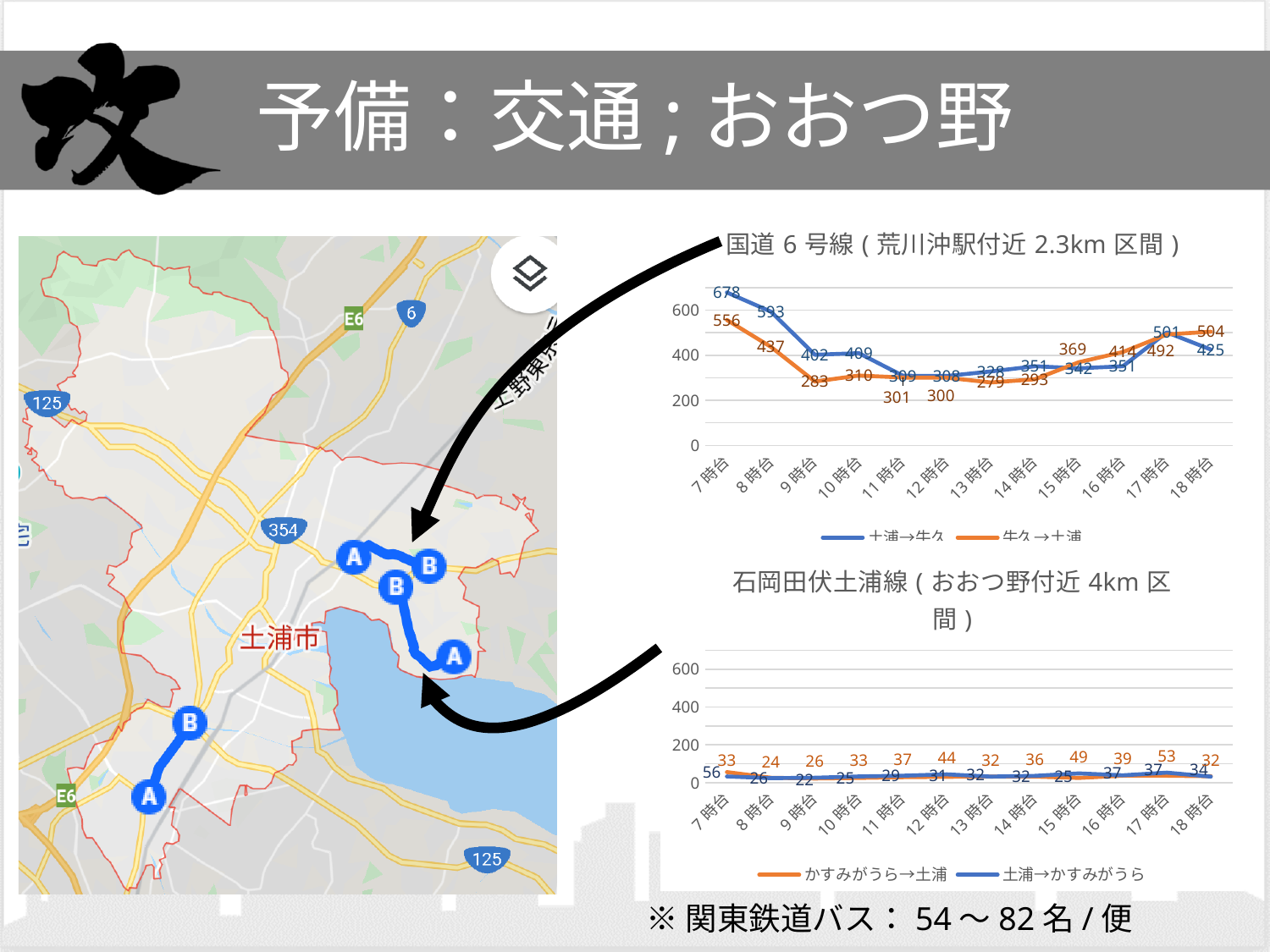
In the bottom chart (石岡田伏土浦線), what is the difference between かすみがうら→土浦 and 土浦→かすみがうら at 15時台? 24 In the top chart (国道6号線), at which time slot is the 牛久→土浦 series lowest? 13時台 In the top chart (国道6号線), what is the value for 牛久→土浦 at 18時台? 504 In the bottom chart (石岡田伏土浦線), at which time slot is the かすみがうら→土浦 series highest? 17時台 How many series does the legend of the bottom chart (石岡田伏土浦線) list? 2 In the top chart (国道6号線), which series has the larger value at 16時台, 土浦→牛久 or 牛久→土浦? 牛久→土浦 In the top chart (国道6号線), what is the difference between 土浦→牛久 and 牛久→土浦 at 7時台? 122 In the bottom chart (石岡田伏土浦線), what is the value for 土浦→かすみがうら at 7時台? 56 What type of chart is the bottom chart (石岡田伏土浦線)? Line chart In the top chart (国道6号線), what is the value for 土浦→牛久 at 7時台? 678 How many time slots are shown on the x axis of the top chart (国道6号線)? 12 In the top chart (国道6号線), at which time slot is the 土浦→牛久 series highest? 7時台